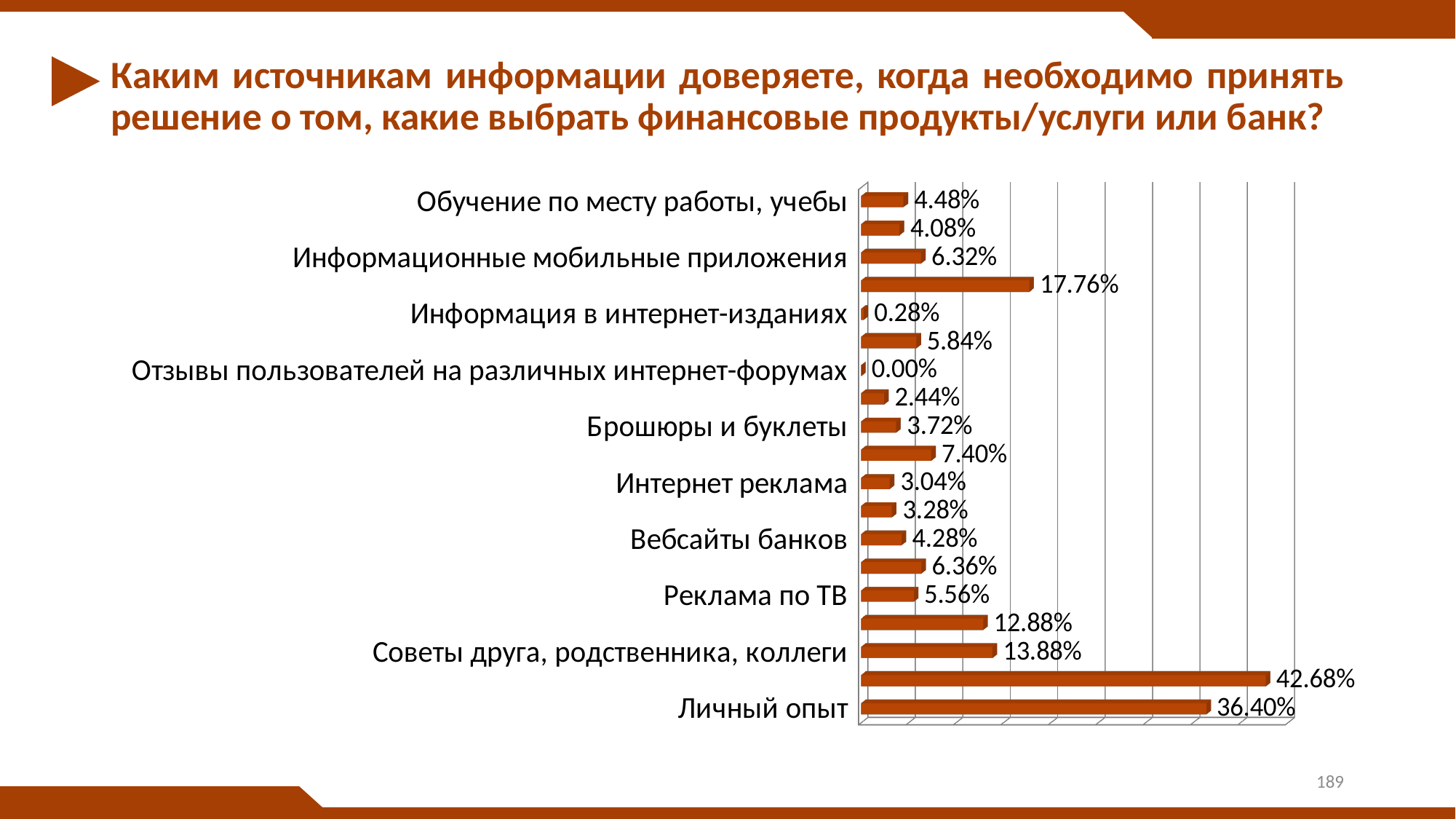
What is the value for "Обучение по месту работы, учебы"? 4.48% How many bars are plotted in the chart? 19 What is the value for "Информационные мобильные приложения"? 6.32% What is the value for "Вебсайты банков"? 4.28% Which is larger, "Брошюры и буклеты" or "Интернет реклама"? Брошюры и буклеты What is the value for "Советы друга, родственника, коллеги"? 13.88% What is the value for "Личный опыт"? 36.40% What kind of chart is shown on the slide? bar chart What is the difference between "Реклама по ТВ" and "Вебсайты банков"? 1.28% Which category has the lowest value? Отзывы пользователей на различных интернет-форумах What is the difference between "Личный опыт" and "Советы друга, родственника, коллеги"? 22.52% What is the value for "Реклама по ТВ"? 5.56%